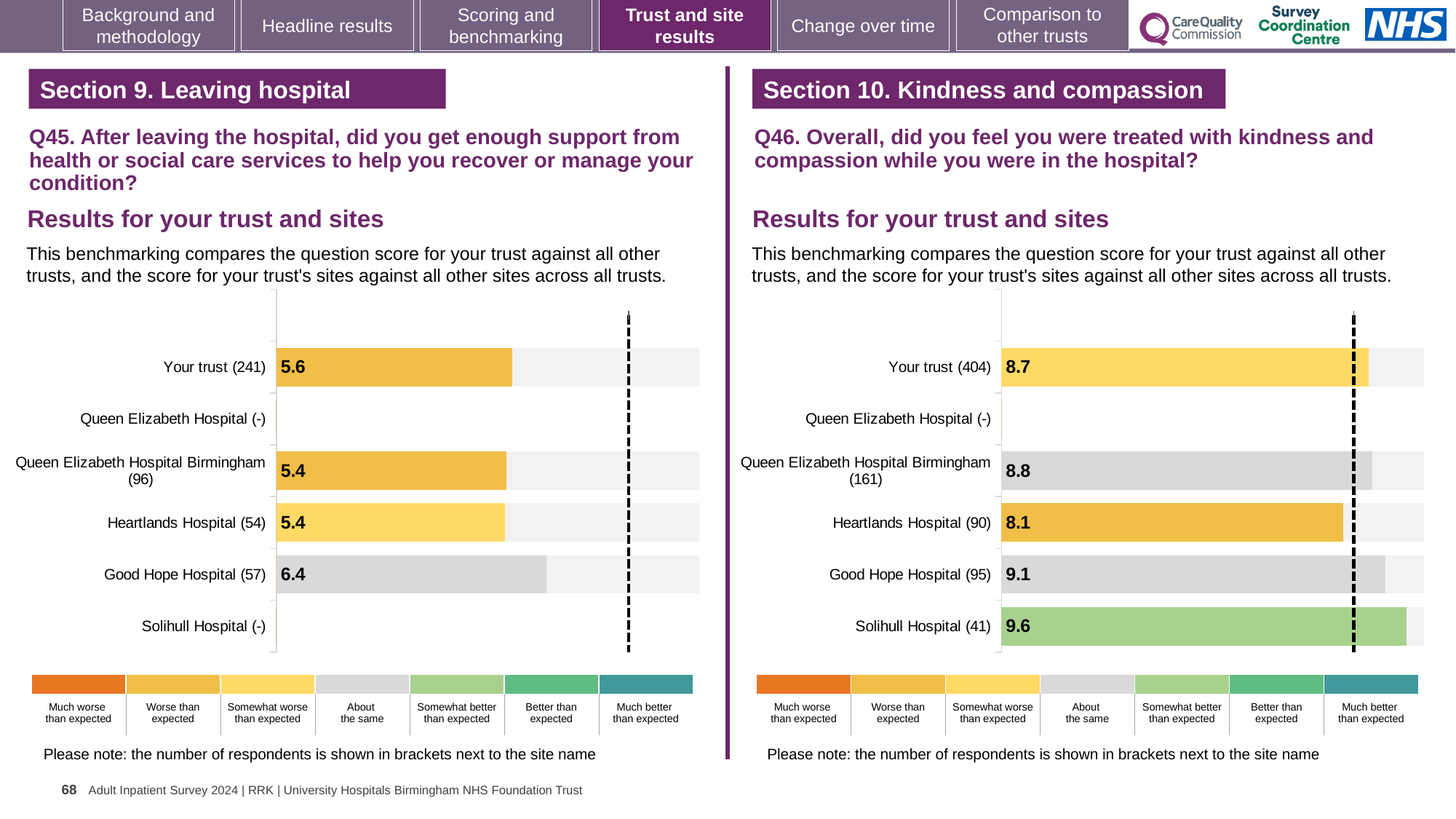
In the Q45 chart on the left, what is the score for Good Hope Hospital? 6.4 In the Q45 chart on the left, what is the score for Your trust? 5.6 In the Q46 chart on the right, what is the score for Solihull Hospital? 9.6 What kind of chart is used for the Q46 results on the right? Bar chart In the Q46 chart on the right, which site has the lowest score? Heartlands Hospital In the Q46 chart on the right, which is larger, the score for Good Hope Hospital or the score for Your trust? Good Hope Hospital In the Q46 chart on the right, how many site or trust categories are listed on the axis? 6 In the Q45 chart on the left, how many respondents are shown for Queen Elizabeth Hospital Birmingham? 96 In the Q46 chart on the right, what is the difference between the scores for Solihull Hospital and Your trust? 0.9 In the Q46 chart on the right, what is the score for Heartlands Hospital? 8.1 In the Q45 chart on the left, which site has the highest score? Good Hope Hospital In the Q45 chart on the left, what is the difference between the scores for Good Hope Hospital and Heartlands Hospital? 1.0